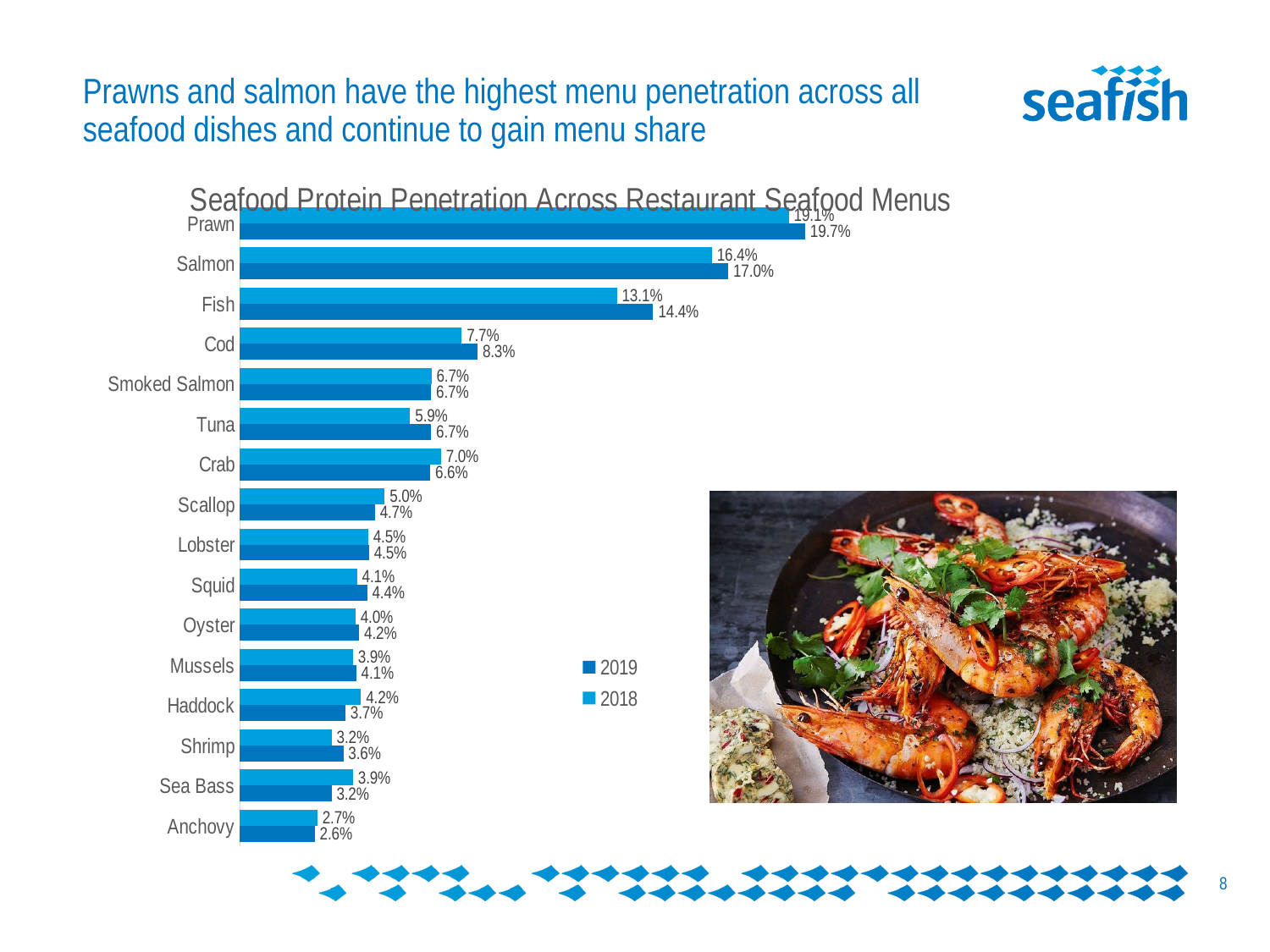
What is the title of the chart? Seafood Protein Penetration Across Restaurant Seafood Menus How many seafood categories are plotted in the chart? 16 How many series does the legend list? 2 Which category has the lowest menu penetration in 2019? Anchovy What kind of chart is shown on the slide? Bar chart What is the 2018 menu penetration value for Salmon? 16.4% What is the 2019 menu penetration value for Prawn? 19.7% What is the 2019 value for Haddock? 3.7% What is the difference between the 2019 and 2018 values for Fish? 1.3% Which is larger for Crab: the 2018 value or the 2019 value? 2018 What is the 2019 value for Fish? 14.4% Which category has the highest menu penetration in 2019? Prawn